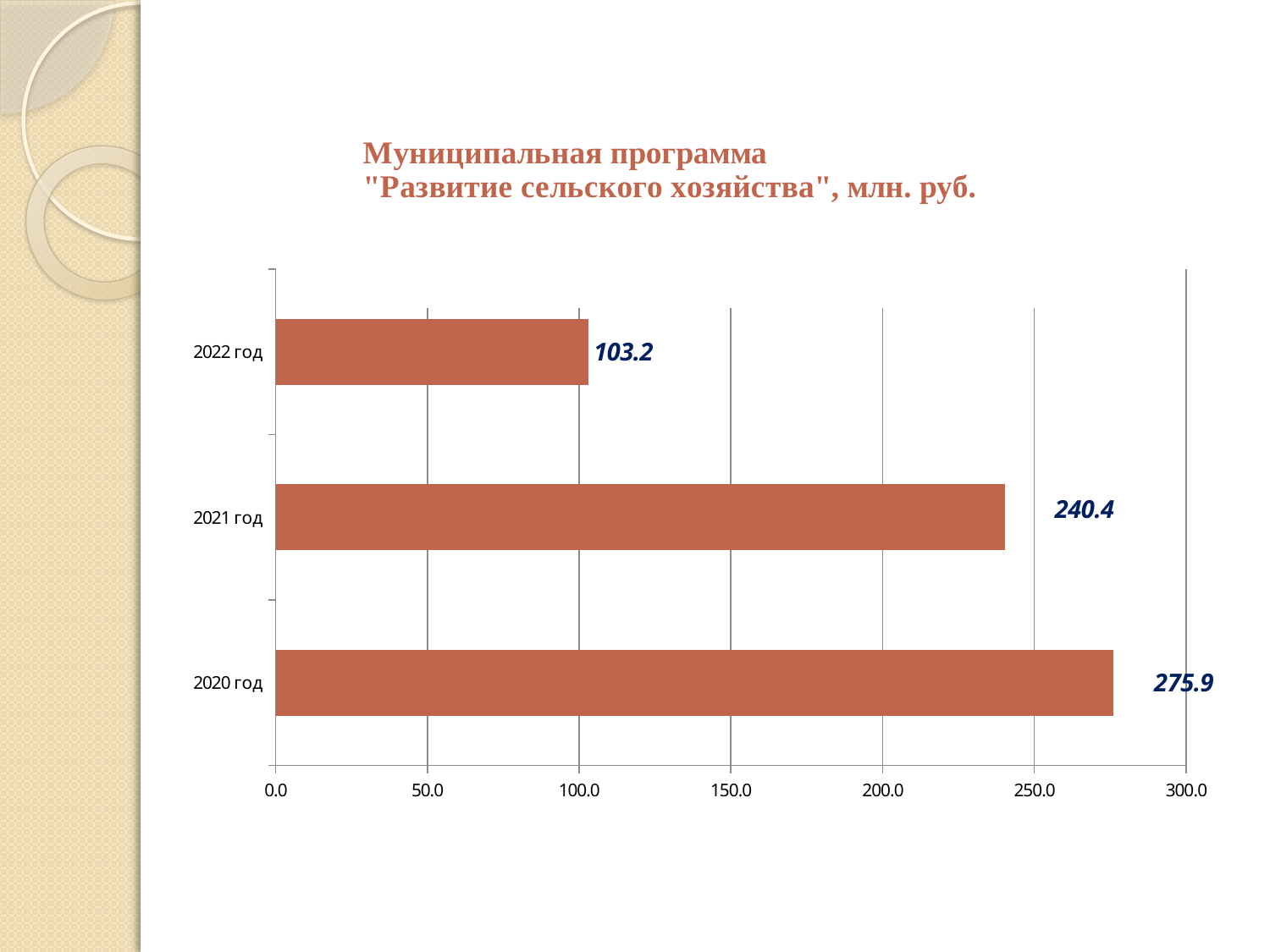
What is the value for 2020 год? 275.9 What is the difference between the values for 2020 год and 2022 год? 172.7 What is the title of the chart? Муниципальная программа "Развитие сельского хозяйства", млн. руб. How many years are shown on the chart? 3 What is the difference between the values for 2021 год and 2022 год? 137.2 What is the value for 2021 год? 240.4 Is the value for 2021 год greater or less than 250.0? less Which year has the lowest value? 2022 год Which is larger, the value for 2021 год or the value for 2022 год? 2021 год Which year has the highest value? 2020 год What is the value for 2022 год? 103.2 What kind of chart is shown on the slide? bar chart